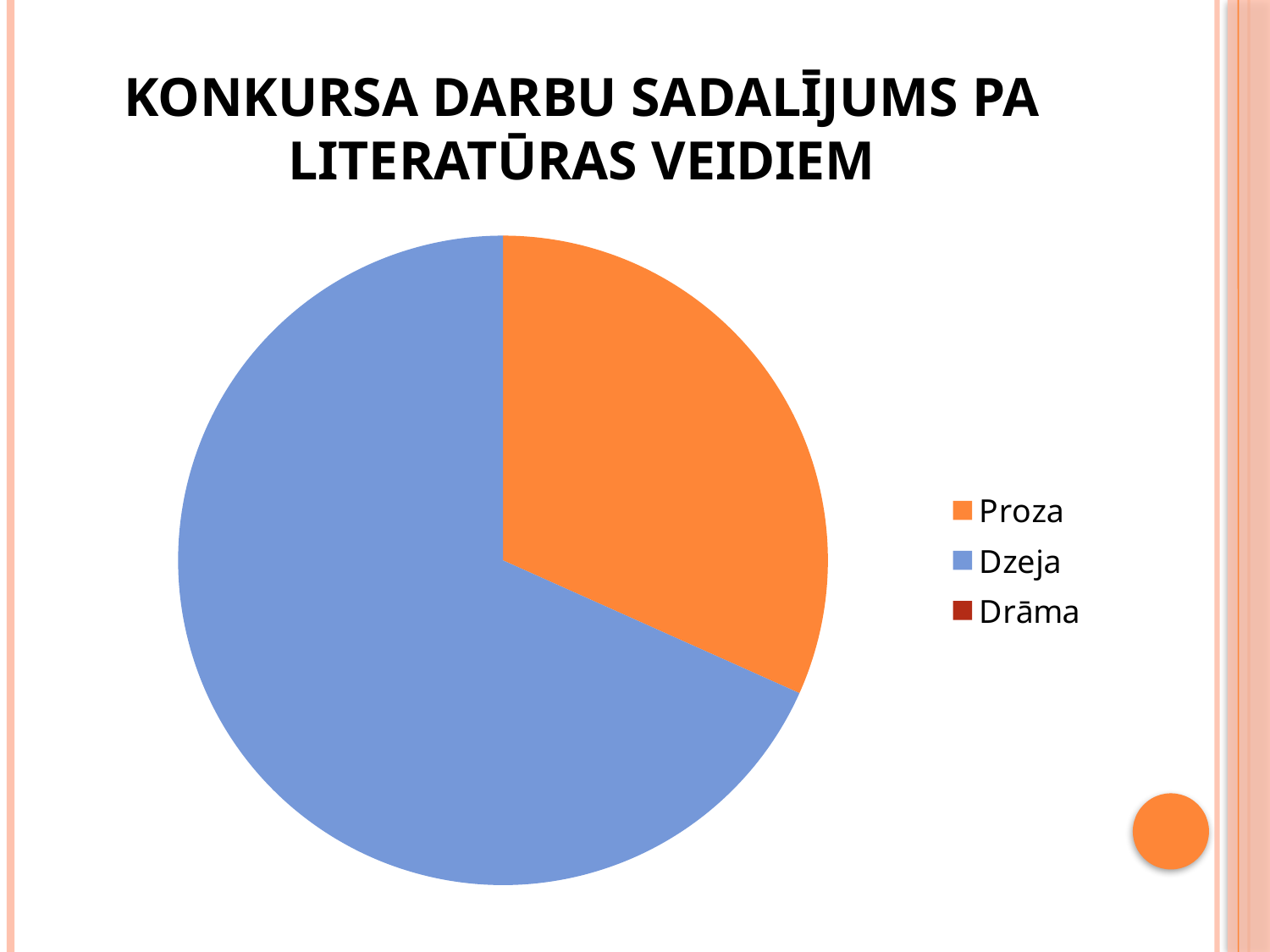
Is the Proza slice more or less than half of the pie? less How many categories does the chart's legend list? 3 What kind of chart is shown on the slide? pie chart Which colour represents Proza in the pie chart? orange What is the title of the chart on the slide? Konkursa darbu sadalījums pa literatūras veidiem Which category has the smallest share of the pie? Drāma Is the Dzeja slice more or less than half of the pie? more Which category has the largest slice of the pie? Dzeja Which slice is larger, Proza or Dzeja? Dzeja Which category is shown in blue in the pie chart? Dzeja